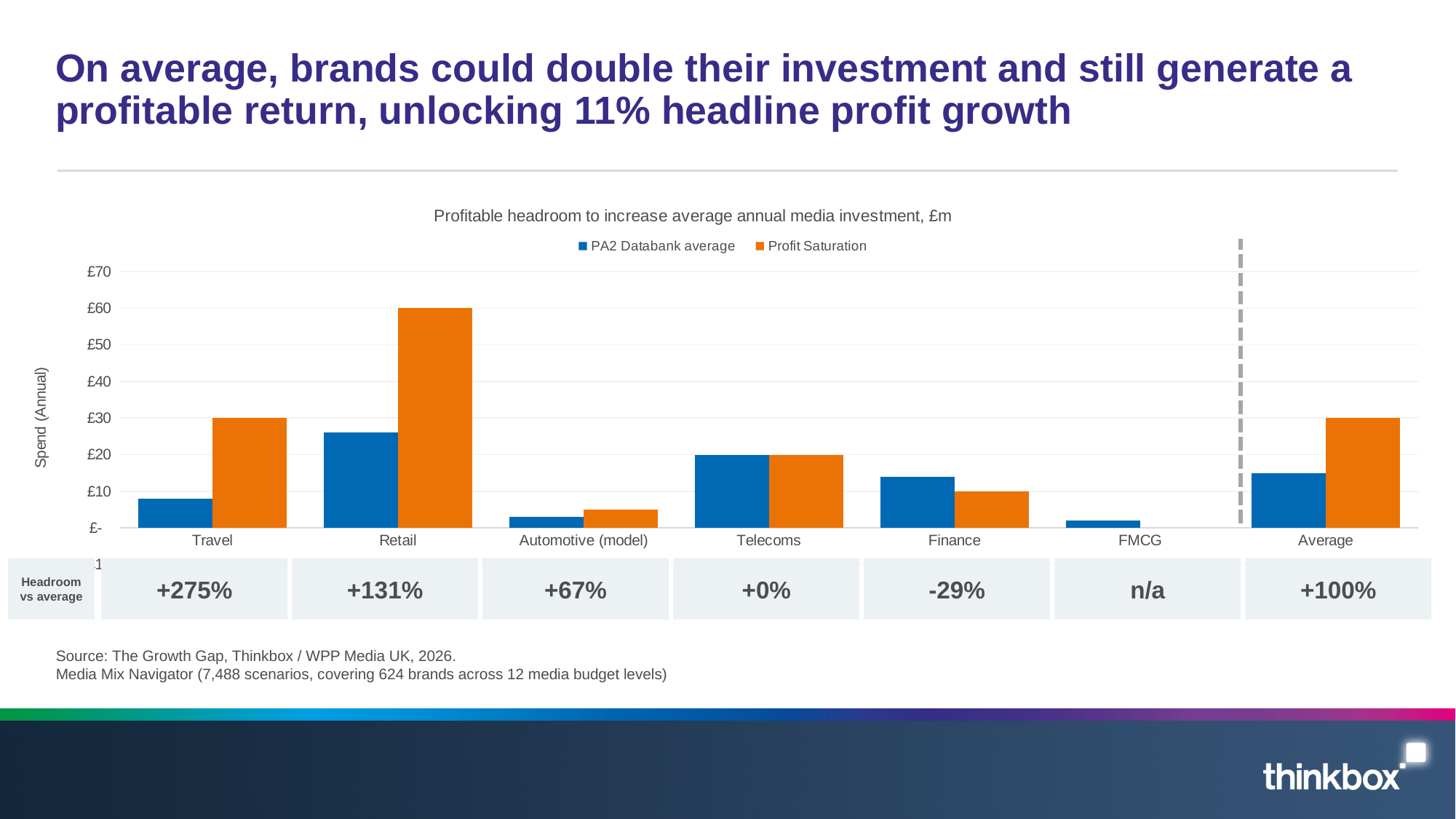
What is the Profit Saturation value for Retail? £60 Which is larger for Finance: the PA2 Databank average or the Profit Saturation value? PA2 Databank average What kind of chart is shown on the slide? Bar chart What is the title of the chart? Profitable headroom to increase average annual media investment, £m Which category has the highest Profit Saturation value? Retail Is the PA2 Databank average value for Travel greater or less than £10? less Is the PA2 Databank average value for Retail greater or less than £20? greater How many categories are shown along the x axis of the chart? 7 How many series does the chart legend list? 2 Which category has the lowest PA2 Databank average value? FMCG What is the Profit Saturation value for Travel? £30 What is the Headroom vs average figure shown for Travel? +275%